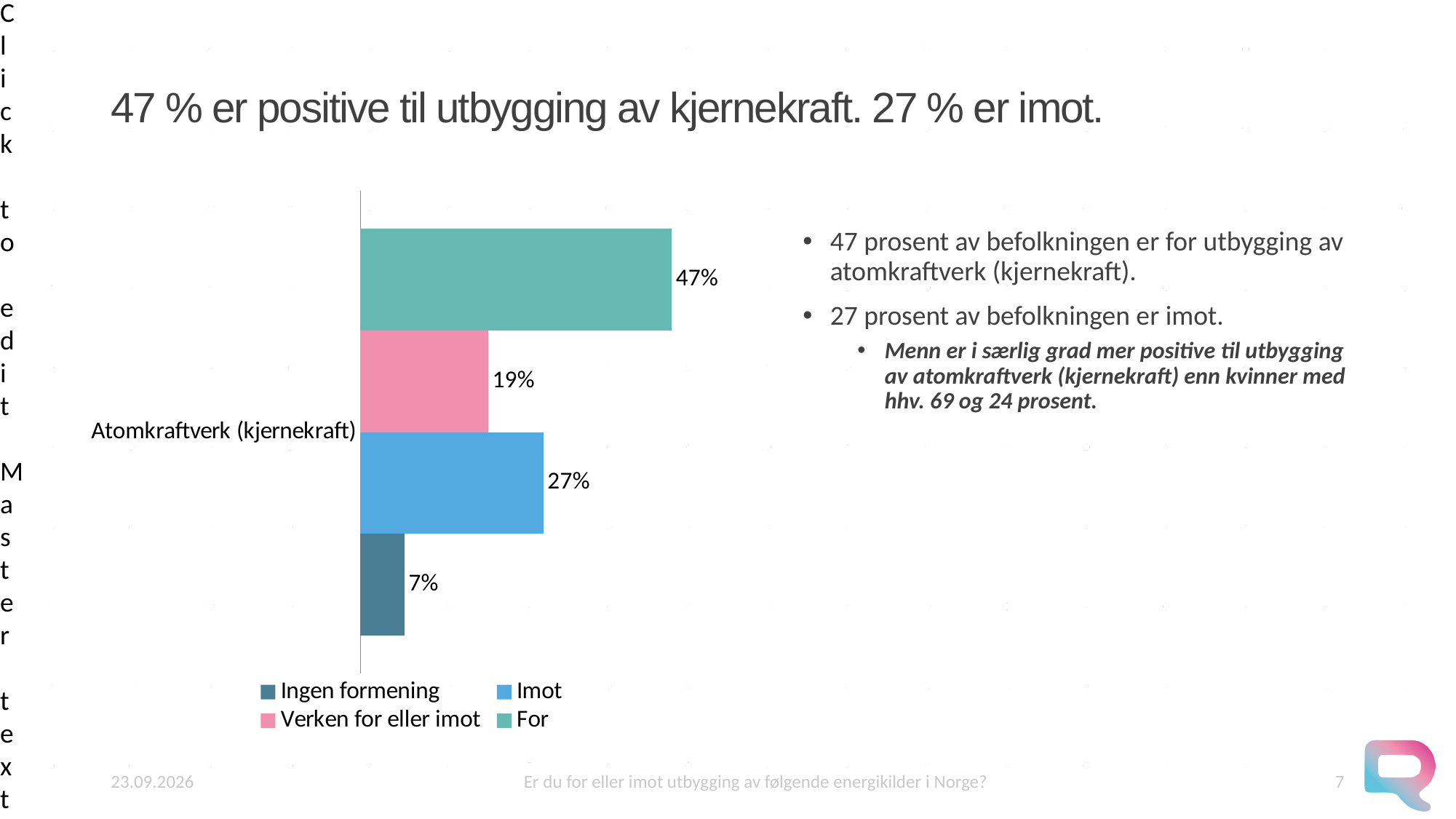
What is the value of the "Ingen formening" series? 7% What kind of chart is shown on the slide? bar chart What is the value of the "Verken for eller imot" series? 19% What is the value of the "Imot" series for Atomkraftverk (kjernekraft)? 27% What is the label of the category shown on the chart's axis? Atomkraftverk (kjernekraft) What is the difference between the "For" value and the "Imot" value? 20% Which series has the highest value in the chart? For How many series does the legend list? 4 Which is larger, the "Imot" value or the "Verken for eller imot" value? Imot Which series has the lowest value in the chart? Ingen formening What is the value of the "For" series for Atomkraftverk (kjernekraft)? 47% How many categories are shown on the category axis of the chart? 1